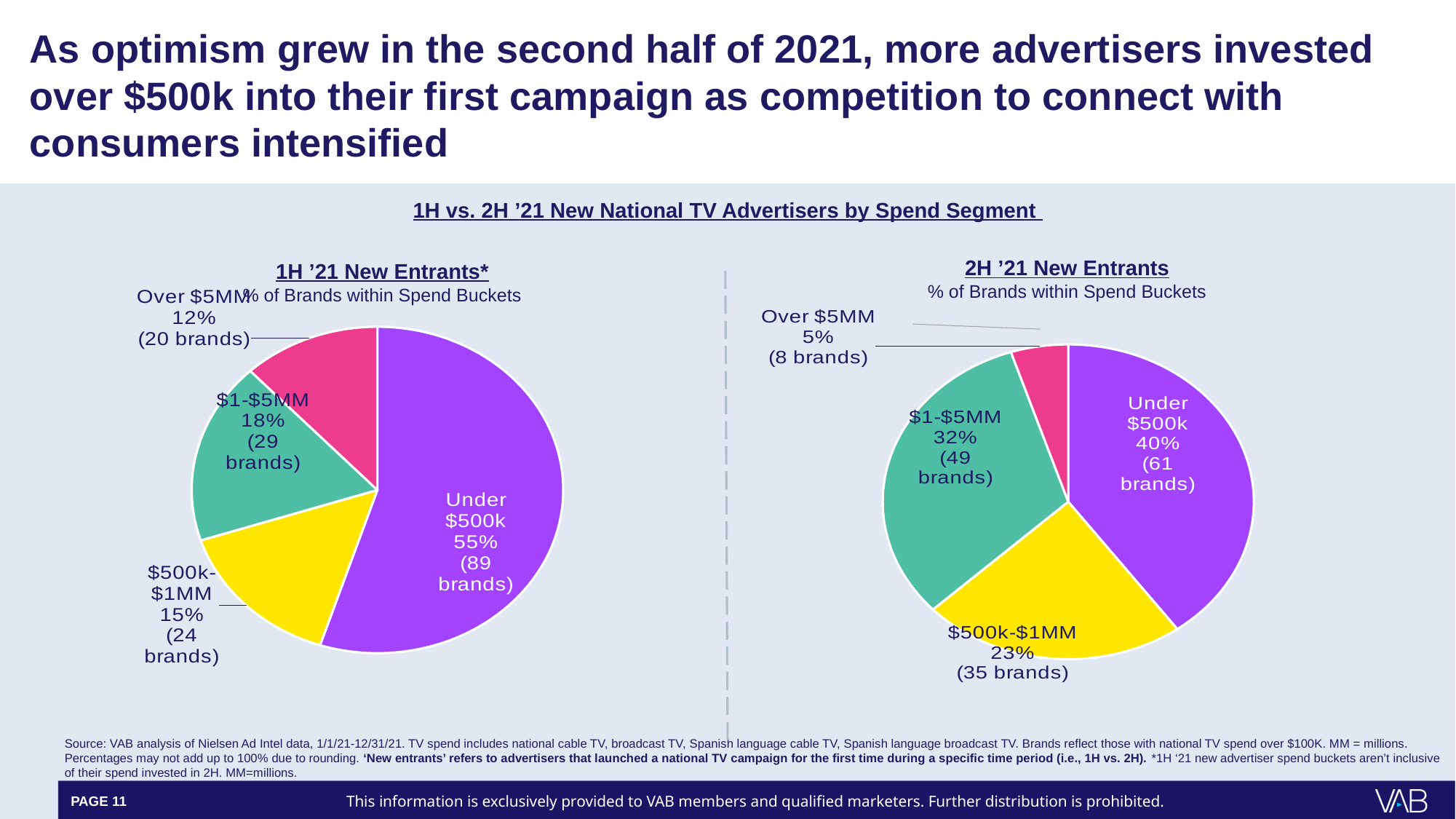
In the 1H '21 New Entrants pie chart, which spend bucket has the smallest share of brands? Over $5MM What type of chart is used for the 1H '21 New Entrants data? Pie chart What is the difference in percentage points between the Under $500k share in the 1H '21 New Entrants chart and the Under $500k share in the 2H '21 New Entrants chart? 15 percentage points In the 2H '21 New Entrants pie chart, how many brands are in the $1-$5MM spend bucket? 49 brands What is the overall title shown above the two pie charts? 1H vs. 2H '21 New National TV Advertisers by Spend Segment In the 1H '21 New Entrants pie chart, how many brands are in the $500k-$1MM spend bucket? 24 brands Which is larger: the $1-$5MM share in the 1H '21 New Entrants chart or the $1-$5MM share in the 2H '21 New Entrants chart? 2H '21 New Entrants In the 1H '21 New Entrants pie chart, what share of brands is in the Under $500k spend bucket? 55% How many spend buckets (slices) does the 2H '21 New Entrants pie chart show? 4 In the 2H '21 New Entrants pie chart, which spend bucket has the largest share of brands? Under $500k In the 1H '21 New Entrants pie chart, how many brands are in the Over $5MM spend bucket? 20 brands In the 2H '21 New Entrants pie chart, what share of brands is in the Over $5MM spend bucket? 5%